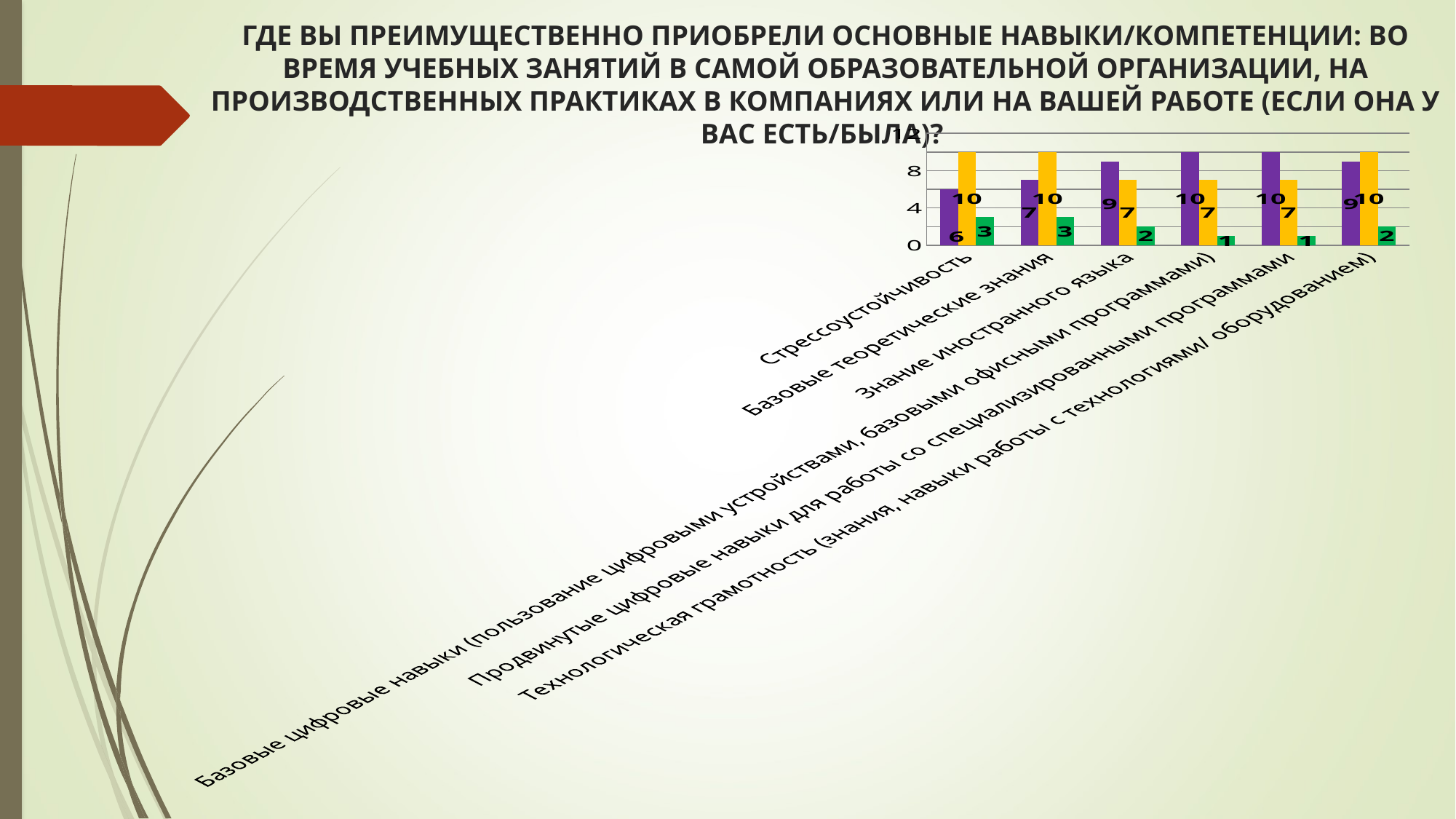
What is the value of the yellow bar for Базовые теоретические знания? 10 Is the value of the green bar for Базовые теоретические знания greater or less than 4? less What is the value of the purple bar for Технологическая грамотность (знания, навыки работы с технологиями/оборудованием)? 9 What is the value of the purple bar for Стрессоустойчивость? 6 What is the difference between the yellow bar and the green bar for Стрессоустойчивость? 7 What kind of chart is shown on the slide? bar chart How many bars are shown for each category in the chart? 3 What is the value of the green bar for Знание иностранного языка? 2 What is the difference between the purple bar and the green bar for Продвинутые цифровые навыки для работы со специализированными программами? 9 Which category has the lowest value for the purple bar? Стрессоустойчивость Which is larger for Знание иностранного языка: the purple bar or the yellow bar? the purple bar How many categories are shown on the x axis of the chart? 6